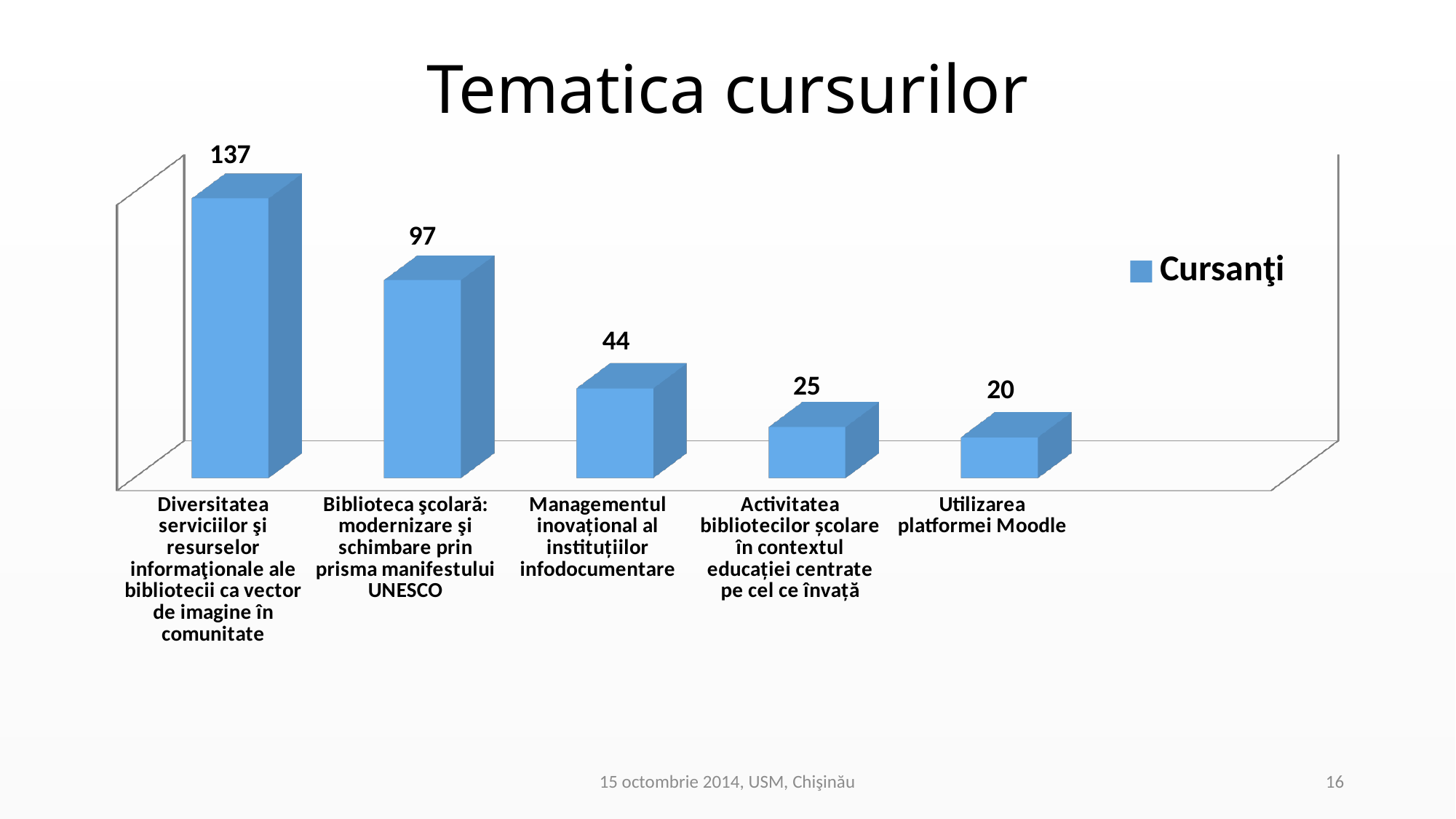
Which has more participants: "Managementul inovațional..." or "Activitatea bibliotecilor școlare..."? Managementul inovațional al instituțiilor infodocumentare What is the difference between the values for "Activitatea bibliotecilor școlare..." and "Utilizarea platformei Moodle"? 5 Which course topic has the lowest number of participants? Utilizarea platformei Moodle Do the values rise or fall from left to right across the categories? Fall What kind of chart is shown on the slide? Bar chart What is the value for "Biblioteca şcolară: modernizare şi schimbare prin prisma manifestului UNESCO"? 97 How many course topics are shown on the chart? 5 How many participants (Cursanţi) are shown for "Utilizarea platformei Moodle"? 20 Which course topic has the highest number of participants? Diversitatea serviciilor şi resurselor informaţionale ale bibliotecii ca vector de imagine în comunitate How many series does the legend list? 1 What is the difference between the values for "Diversitatea serviciilor..." (137) and "Biblioteca şcolară..." (97)? 40 What is the value for "Managementul inovațional al instituțiilor infodocumentare"? 44